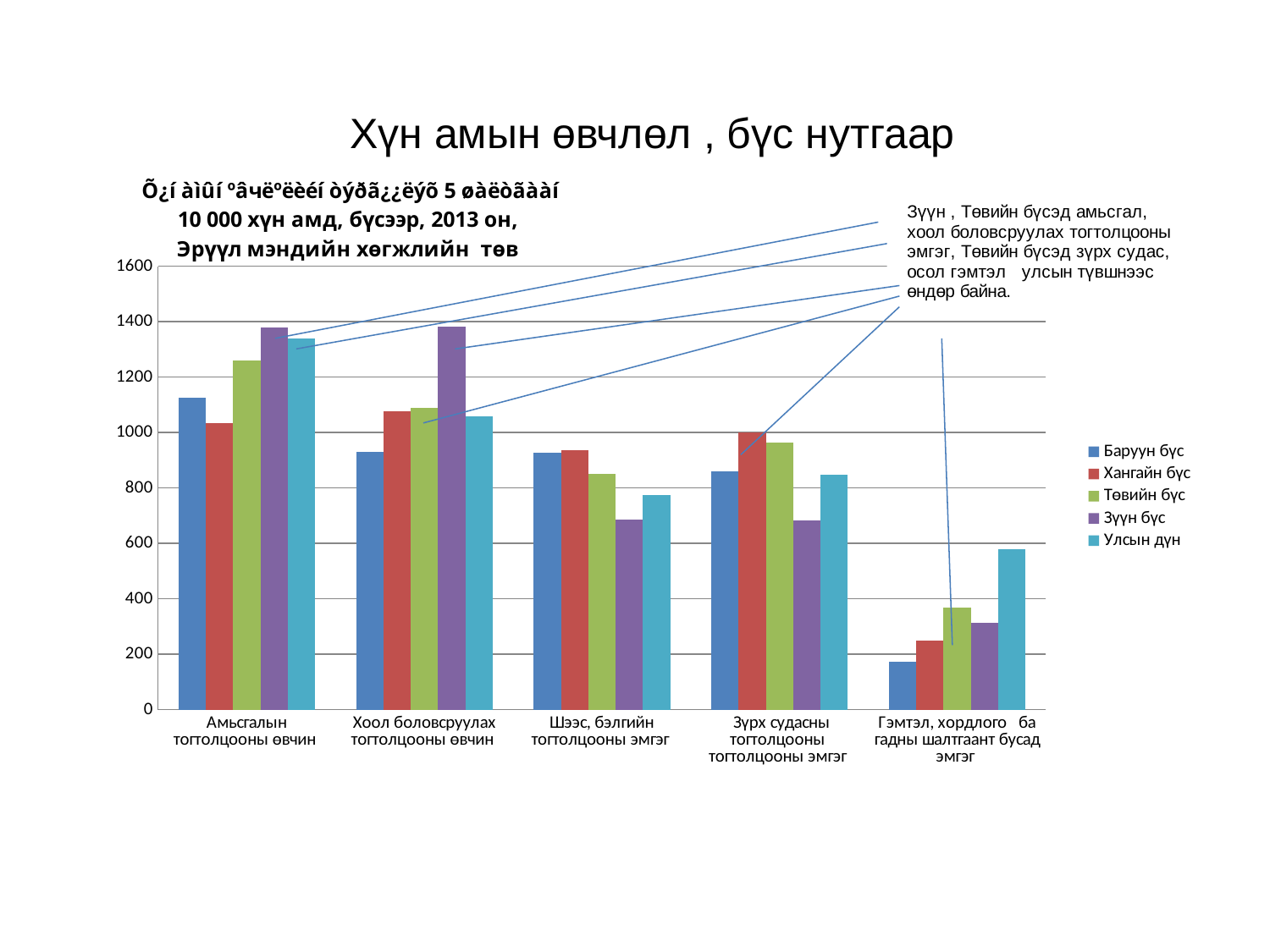
How many categories are shown along the x axis of the chart? 5 How many series does the chart's legend list? 5 Is the Зүүн бүс value for Амьсгалын тогтолцооны өвчин greater or less than 1200? greater Do the Баруун бүс values generally rise or fall from left to right across the categories? fall Which series has the highest value for Гэмтэл, хордлого ба гадны шалтгаант бусад эмгэг? Улсын дүн Is the Баруун бүс value for Гэмтэл, хордлого ба гадны шалтгаант бусад эмгэг greater or less than 200? less What kind of chart is shown on the slide? bar chart Is the Зүүн бүс value for Шээс, бэлгийн тогтолцооны эмгэг greater or less than 800? less For Шээс, бэлгийн тогтолцооны эмгэг, which is larger: the Төвийн бүс value or the Улсын дүн value? Төвийн бүс For the Баруун бүс series, which category has the lowest value? Гэмтэл, хордлого ба гадны шалтгаант бусад эмгэг Which series is listed last in the chart's legend? Улсын дүн